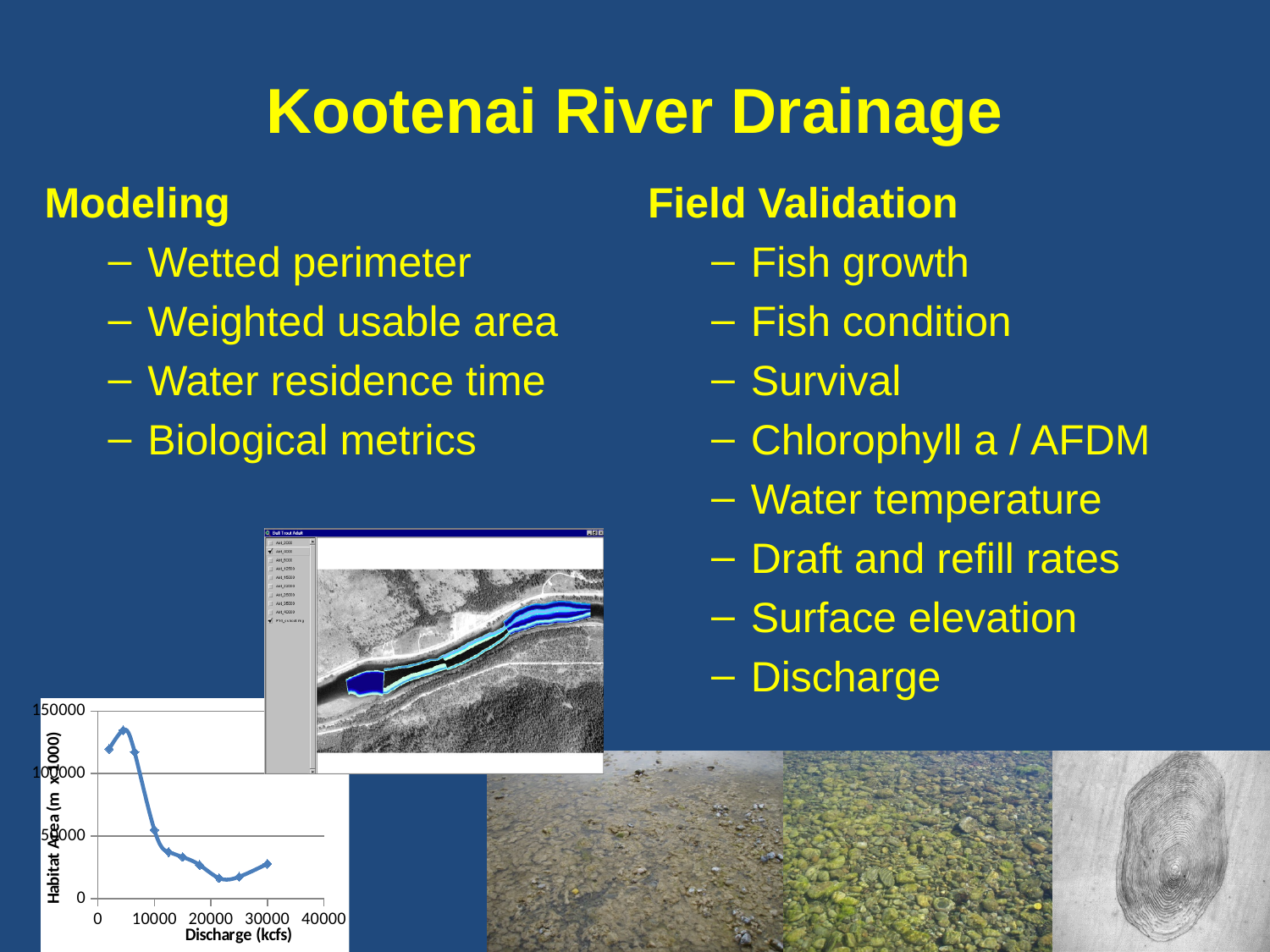
What is the highest value shown on the y axis of the chart at the bottom left? 150000 What kind of chart is shown at the bottom left of the slide? line chart In the chart at the bottom left, which is larger: the habitat area at a discharge of 10000 kcfs or at 20000 kcfs? 10000 kcfs In the chart at the bottom left, is the habitat area at the first plotted point (lowest discharge) greater or less than 100000? greater What is the label of the y axis of the chart at the bottom left? Habitat Area (m x 1000) In the chart at the bottom left, does habitat area rise or fall as discharge increases from about 5000 to 20000 kcfs? fall In the chart at the bottom left, is the habitat area at a discharge of 10000 kcfs greater or less than 100000? less In the chart at the bottom left, is the highest habitat area value greater or less than 100000? greater What is the label of the x axis of the chart at the bottom left? Discharge (kcfs)